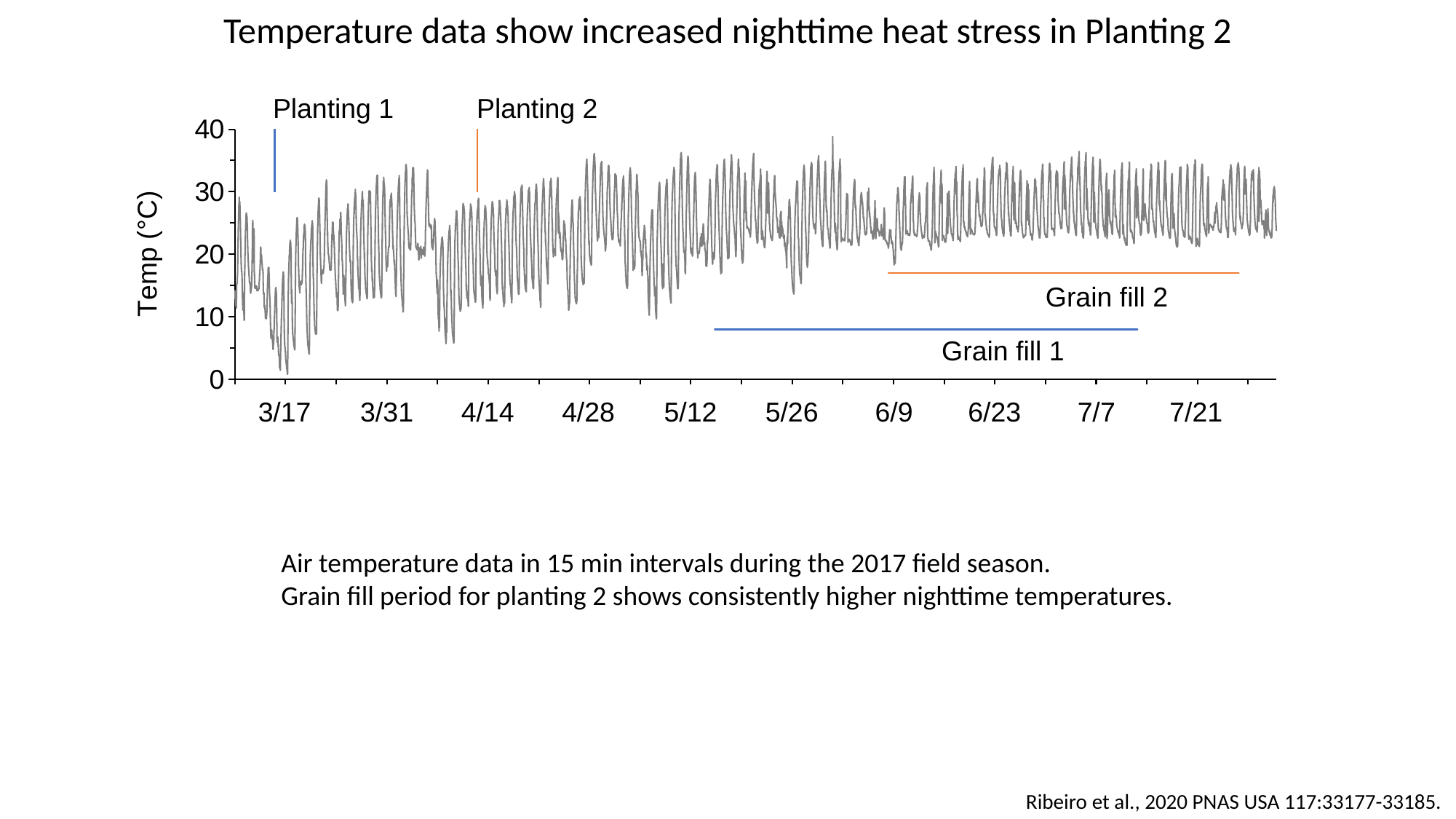
How many date labels are shown on the x axis? 10 What is the label of the y axis? Temp (°C) Is the highest temperature reached on the chart greater or less than 30? greater Is the lowest temperature reached around 3/17 greater or less than 10? less What kind of chart is shown on the slide? line chart What is the title of the slide's chart? Temperature data show increased nighttime heat stress in Planting 2 Do the temperatures generally rise or fall from March to July along the x axis? rise Which planting is marked earlier on the x axis, Planting 1 or Planting 2? Planting 1 What is the highest tick value shown on the y axis? 40 Are the nighttime low temperatures during the Grain fill 2 period greater or less than 10? greater Which grain fill period ends later, Grain fill 1 or Grain fill 2? Grain fill 2 How many planting dates are marked on the chart? 2